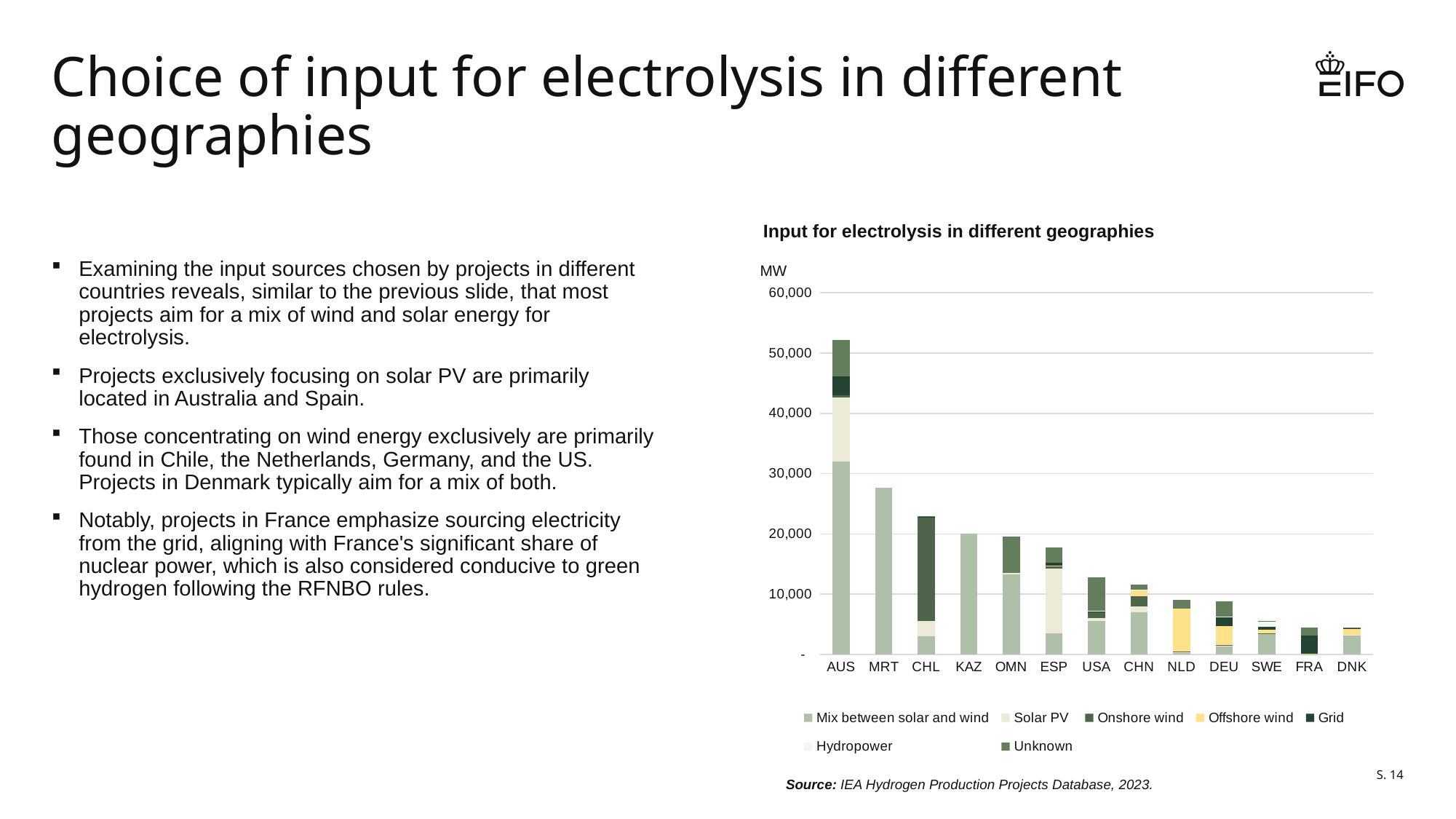
Which has the larger total bar, MRT or CHL? MRT What kind of chart is shown on the slide? bar chart Is the total value for DEU greater or less than 10,000? less How many countries are shown on the x axis of the chart? 13 Is the total value for MRT greater or less than 30,000? less How many series does the chart's legend list? 7 Which country has the highest total bar in the chart? AUS Is the total value for CHL greater or less than 20,000? greater What unit is shown on the y axis of the chart? MW Do the total bar heights generally rise or fall from left to right along the x axis? fall